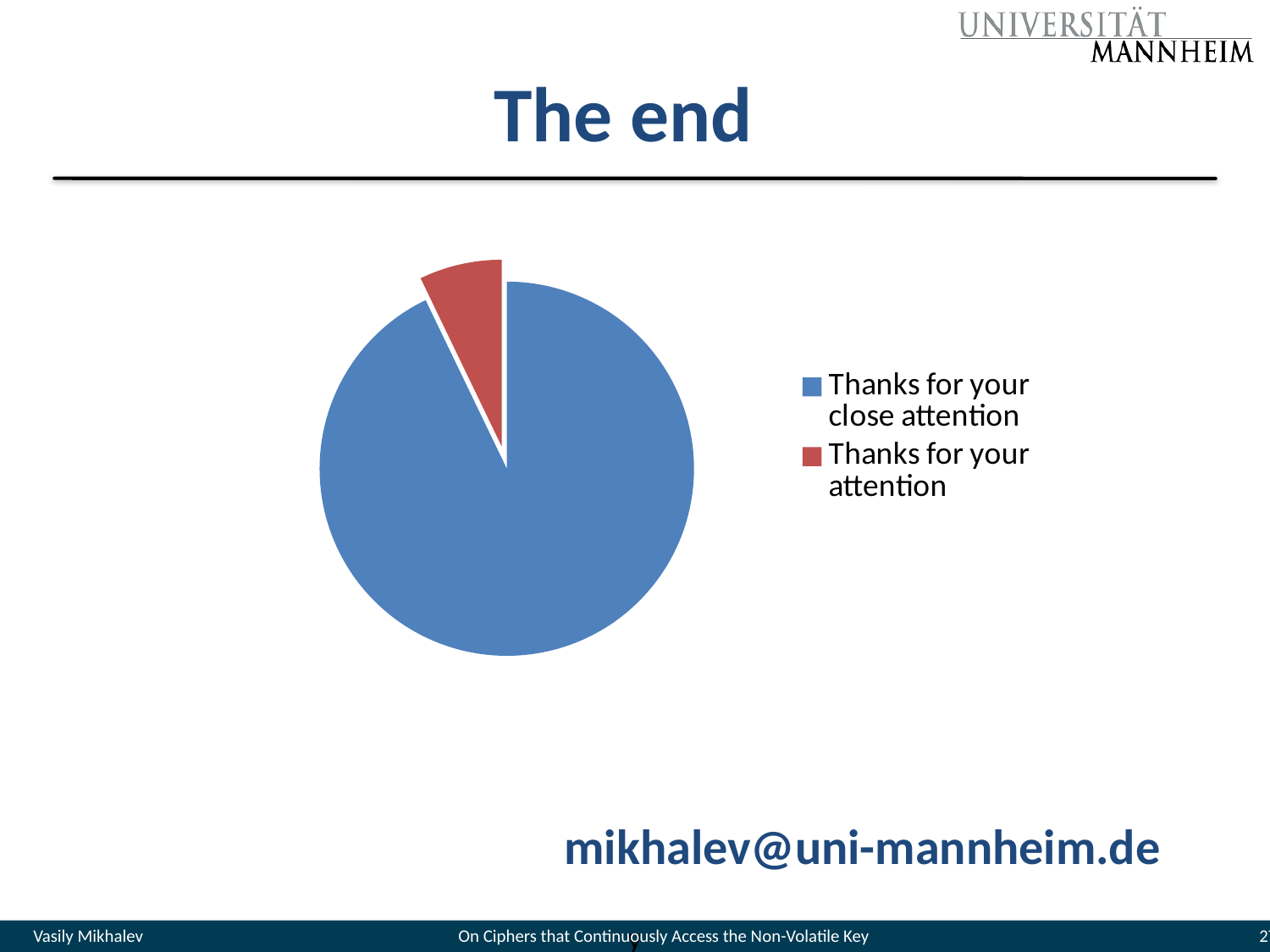
What colour is the "Thanks for your attention" slice in the pie chart? red Which slice of the pie chart is the smallest? Thanks for your attention How many entries does the legend of the pie chart list? 2 How many slices does the pie chart have? 2 Which slice is larger, "Thanks for your close attention" or "Thanks for your attention"? Thanks for your close attention Which slice of the pie chart is the largest? Thanks for your close attention What kind of chart is shown on the slide? pie chart What colour is the "Thanks for your close attention" slice in the pie chart? blue